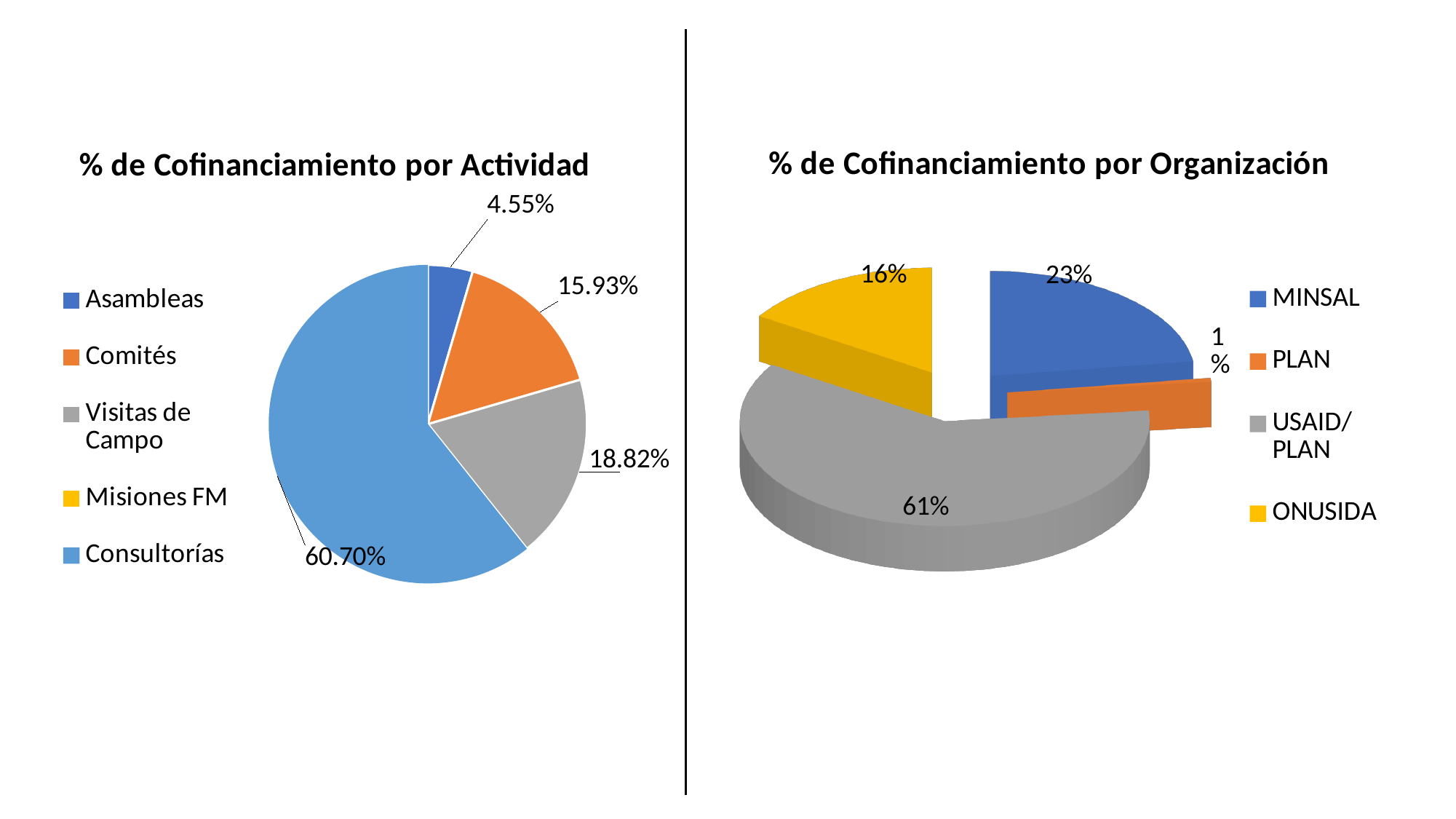
In the chart titled '% de Cofinanciamiento por Actividad', what percentage is shown for Comités? 15.93% In the chart titled '% de Cofinanciamiento por Organización', which is larger, the share for MINSAL or the share for ONUSIDA? MINSAL In the chart titled '% de Cofinanciamiento por Organización', what percentage is shown for MINSAL? 23% In the chart titled '% de Cofinanciamiento por Actividad', how many entries does the legend list? 5 In the chart titled '% de Cofinanciamiento por Actividad', what percentage is shown for Consultorías? 60.70% In the chart titled '% de Cofinanciamiento por Organización', what percentage is shown for USAID/PLAN? 61% In the chart titled '% de Cofinanciamiento por Actividad', which category has the largest share? Consultorías In the chart titled '% de Cofinanciamiento por Actividad', what is the difference between the Consultorías and Visitas de Campo percentages? 41.88% In the chart titled '% de Cofinanciamiento por Organización', which organization has the smallest share? PLAN What type of chart is the one titled '% de Cofinanciamiento por Organización'? Pie chart In the chart titled '% de Cofinanciamiento por Actividad', what percentage is shown for Asambleas? 4.55% In the chart titled '% de Cofinanciamiento por Organización', what is the difference between the USAID/PLAN and MINSAL percentages? 38%